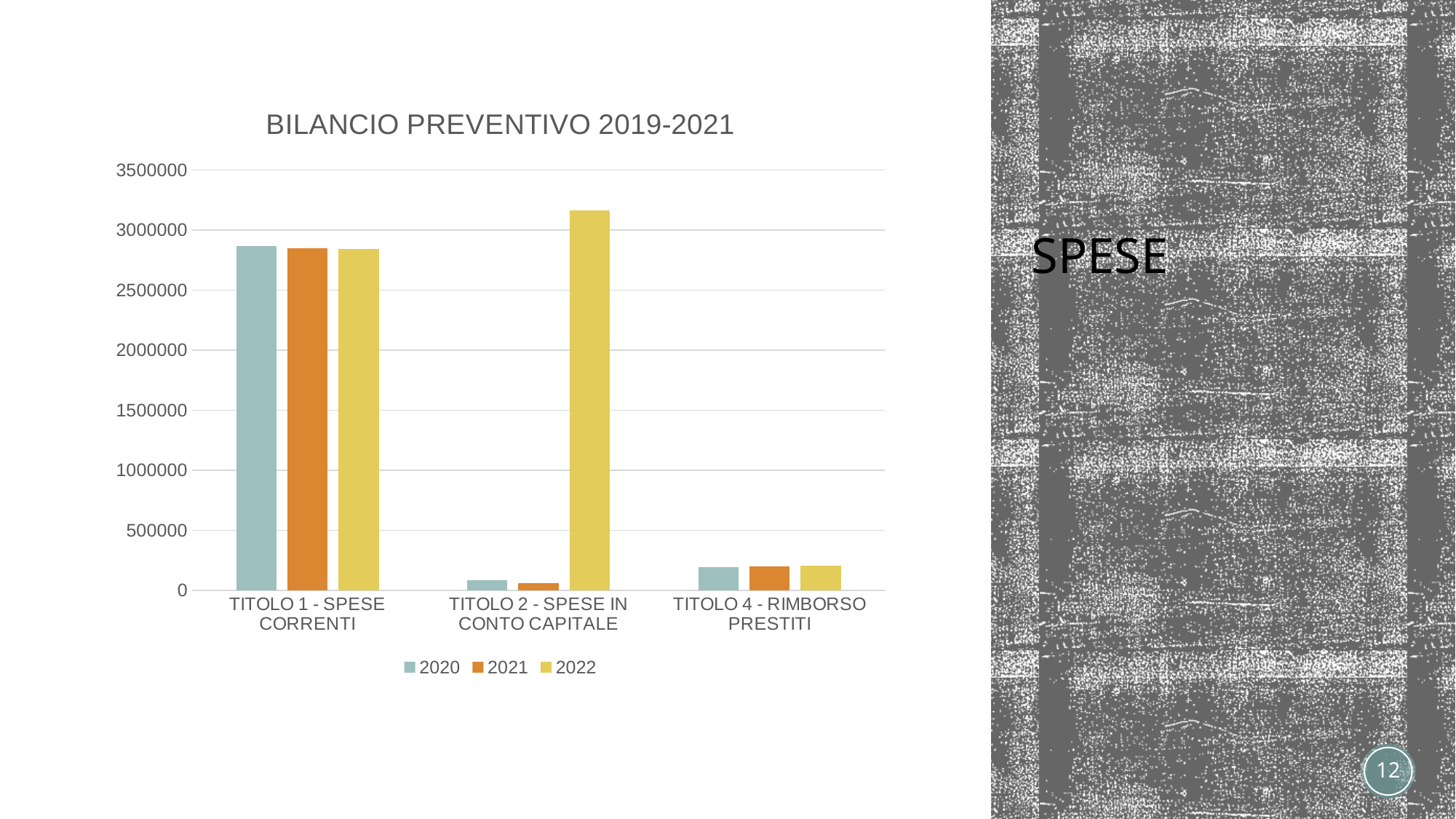
Is the 2022 value for TITOLO 2 - SPESE IN CONTO CAPITALE greater or less than 3000000? greater How many categories are shown on the x axis? 3 Which category has the lowest value for the 2021 series? TITOLO 2 - SPESE IN CONTO CAPITALE For the 2020 series, which is larger, TITOLO 1 - SPESE CORRENTI or TITOLO 4 - RIMBORSO PRESTITI? TITOLO 1 - SPESE CORRENTI What kind of chart is shown on the slide? bar chart Is the 2020 value for TITOLO 1 - SPESE CORRENTI greater or less than 3000000? less For TITOLO 2 - SPESE IN CONTO CAPITALE, which series has the larger value, 2020 or 2022? 2022 What is the title of the chart? BILANCIO PREVENTIVO 2019-2021 How many series does the legend list? 3 Which category has the highest value for the 2022 series? TITOLO 2 - SPESE IN CONTO CAPITALE Is the 2021 value for TITOLO 4 - RIMBORSO PRESTITI greater or less than 500000? less Which series are listed in the legend? 2020, 2021, 2022